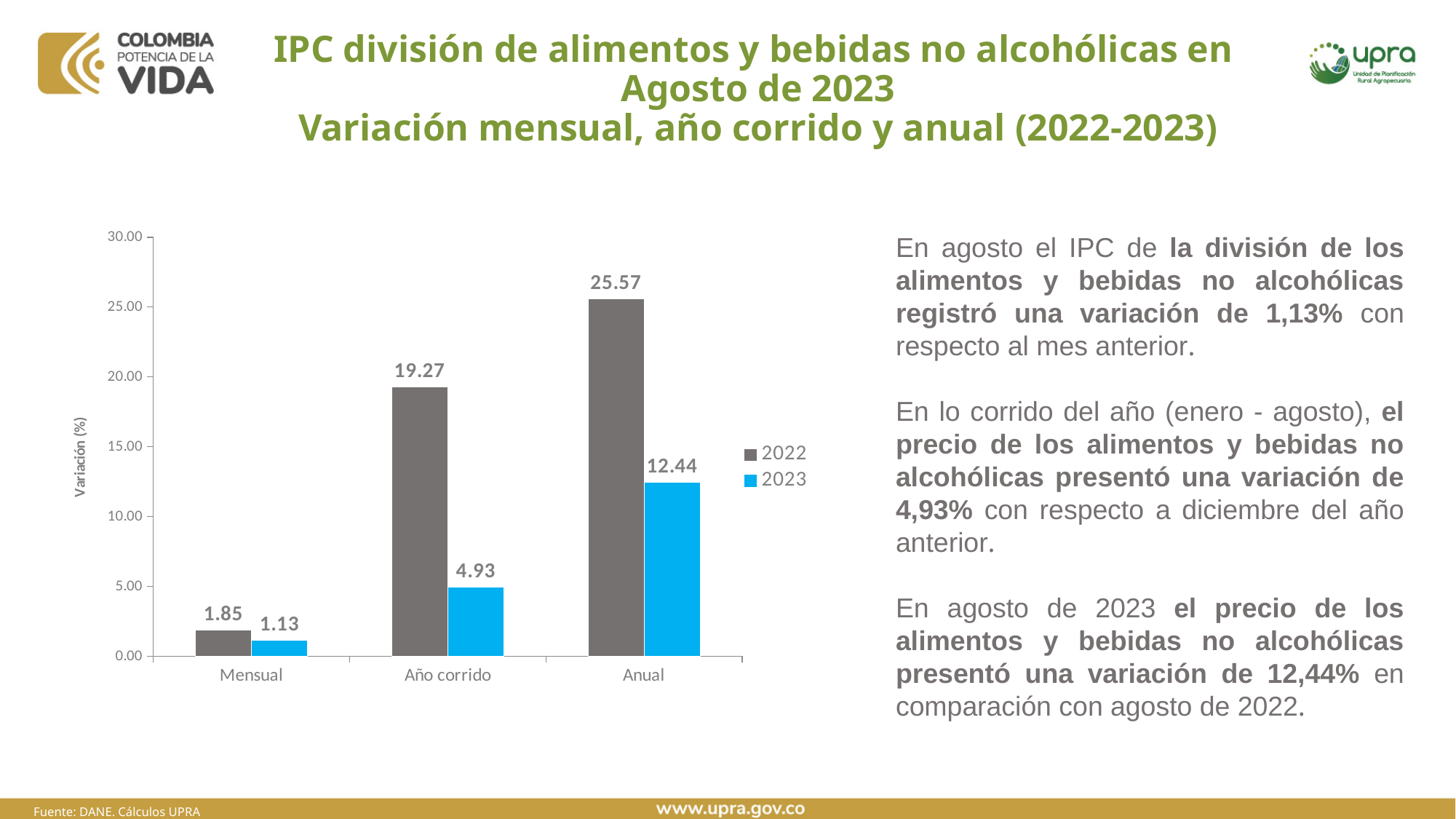
What is the value for 2022 in the Anual category? 25.57 Which category has the lowest value for the 2023 series? Mensual What is the label of the y axis? Variación (%) Which category has the highest value for the 2022 series? Anual Which is larger in the Mensual category, the 2022 value or the 2023 value? 2022 What kind of chart is shown on the slide? Bar chart What is the difference between the 2022 and 2023 values in the Anual category? 13.13 What is the difference between the 2022 and 2023 values in the Año corrido category? 14.34 How many series does the legend list? 2 What is the value for 2023 in the Año corrido category? 4.93 What is the value for 2023 in the Mensual category? 1.13 How many categories are shown on the x axis? 3